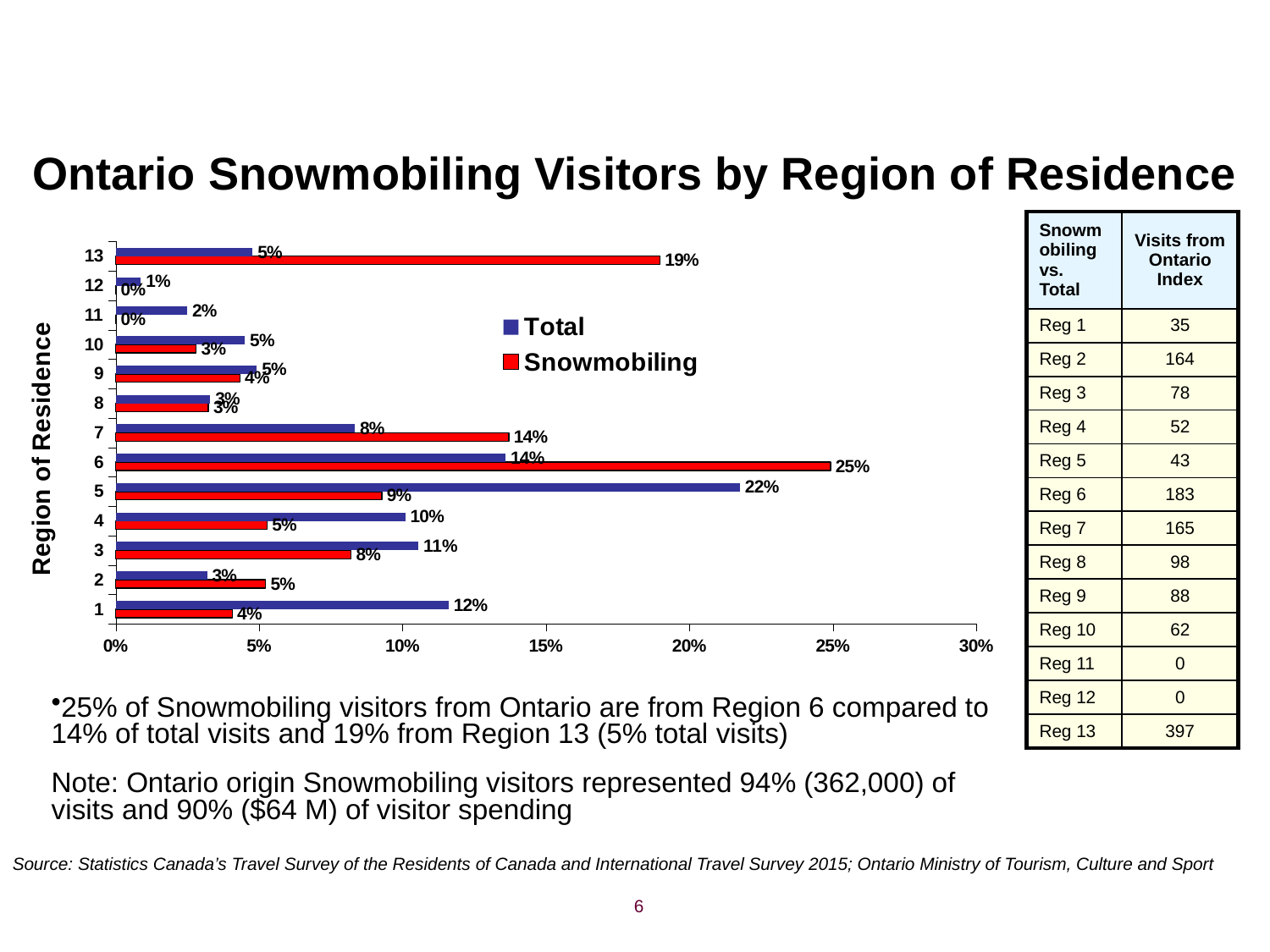
For Region 7, which is larger: the Total value or the Snowmobiling value? Snowmobiling What is the Total value for Region 5? 22% How many regions of residence are shown on the chart? 13 What is the Snowmobiling value for Region 6? 25% What type of chart is shown on the slide? Bar chart What is the difference between the Snowmobiling and Total values for Region 6? 11% What is the Snowmobiling value for Region 13? 19% What is the Total value for Region 1? 12% Which region has the highest Snowmobiling value? Region 6 How many series does the chart legend list? 2 Is the Total value for Region 5 greater or less than 20%? greater Which region has the highest Total value? Region 5